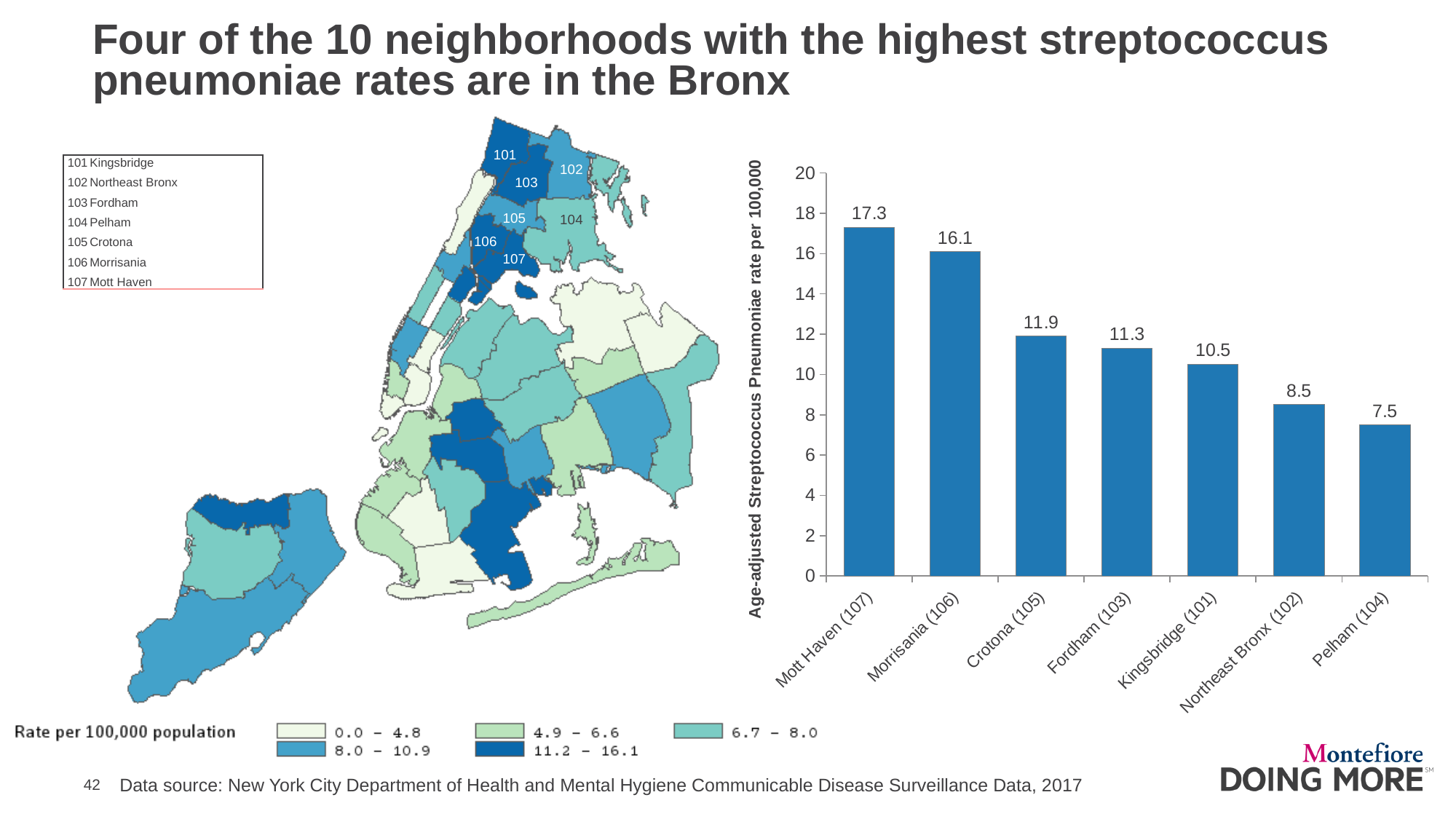
In the bar chart, which neighborhood has the lowest rate? Pelham (104) In the bar chart, what is the rate for Pelham (104)? 7.5 In the bar chart, which neighborhood has the highest rate? Mott Haven (107) Do the values in the bar chart rise or fall from left to right? Fall How many neighborhoods are shown in the bar chart? 7 In the bar chart, what is the rate for Northeast Bronx (102)? 8.5 In the bar chart, what is the difference between the rates for Fordham (103) and Kingsbridge (101)? 0.8 What kind of chart is shown on the right side of the slide? Bar chart In the bar chart, which has a higher rate, Crotona (105) or Fordham (103)? Crotona (105) In the bar chart, what is the difference between the rates for Mott Haven (107) and Morrisania (106)? 1.2 In the bar chart, what is the rate for Crotona (105)? 11.9 In the bar chart, what is the age-adjusted Streptococcus pneumoniae rate per 100,000 for Mott Haven (107)? 17.3